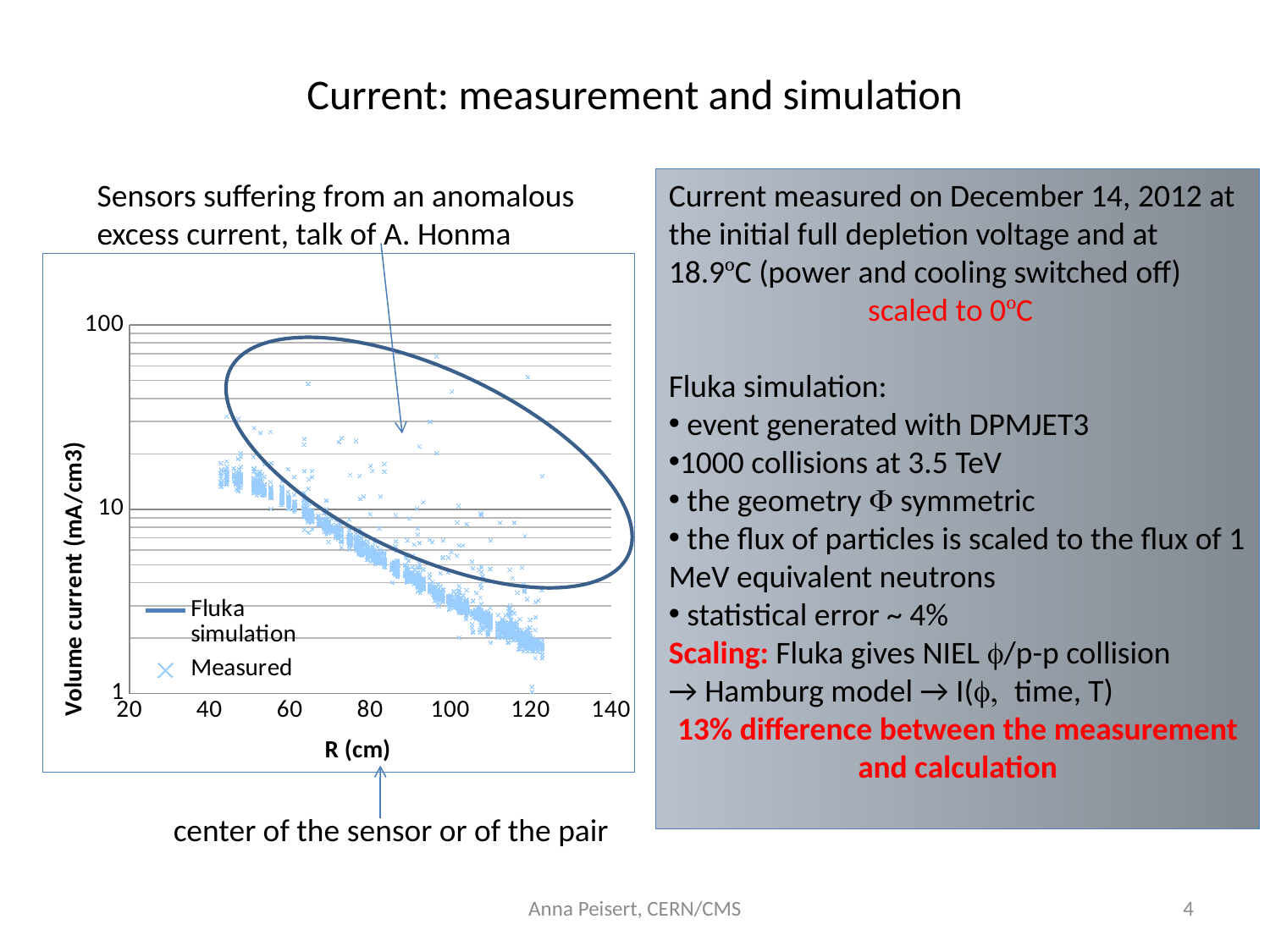
Do the measured volume current values rise or fall as R increases along the x axis? fall Which has the larger measured volume current, the sensors at R = 40 cm or those at R = 120 cm? R = 40 cm What are the two series named in the chart legend? Fluka simulation and Measured What is the label of the x axis of the chart? R (cm) Are the measured volume current values at R = 120 cm greater or less than 10 mA/cm3? less Are the measured volume current values near R = 40 cm greater or less than 10 mA/cm3? greater How many series does the chart legend list? 2 What kind of chart is shown on the slide? scatter chart What is the highest value shown on the y axis of the chart? 100 Are the measured volume current values at R = 60 cm greater or less than 100 mA/cm3? less